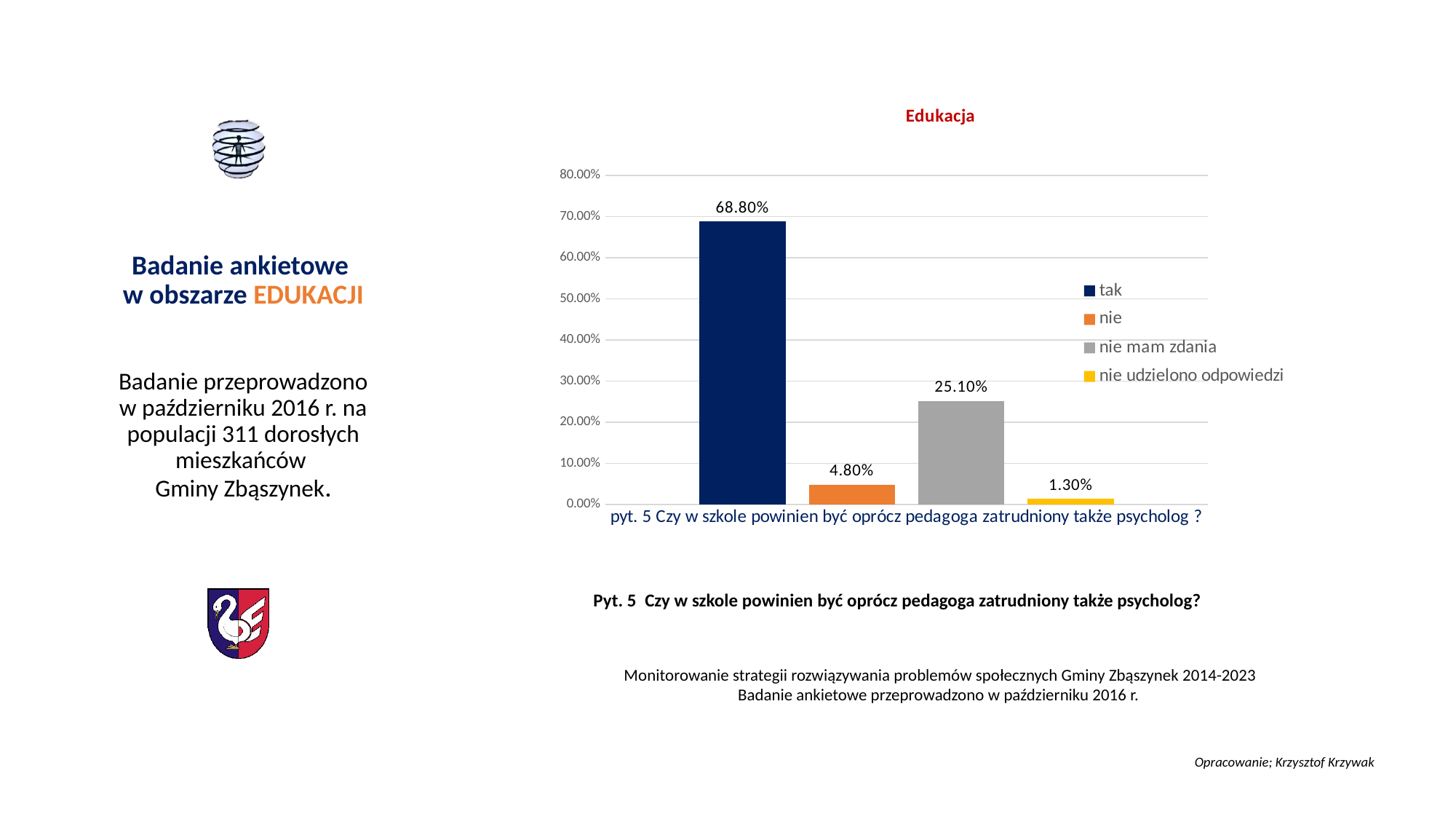
What is the difference between the values for "tak" and "nie mam zdania"? 43.70% Is the value for "tak" greater or less than 60.00%? greater Which is larger, the value for "nie" or the value for "nie mam zdania"? nie mam zdania What is the title of the chart? Edukacja What is the value for "tak"? 68.80% Which response has the highest value? tak Which response has the lowest value? nie udzielono odpowiedzi How many series does the legend list? 4 What is the value for "nie udzielono odpowiedzi"? 1.30% What kind of chart is shown? bar chart What is the value for "nie"? 4.80% What is the value for "nie mam zdania"? 25.10%